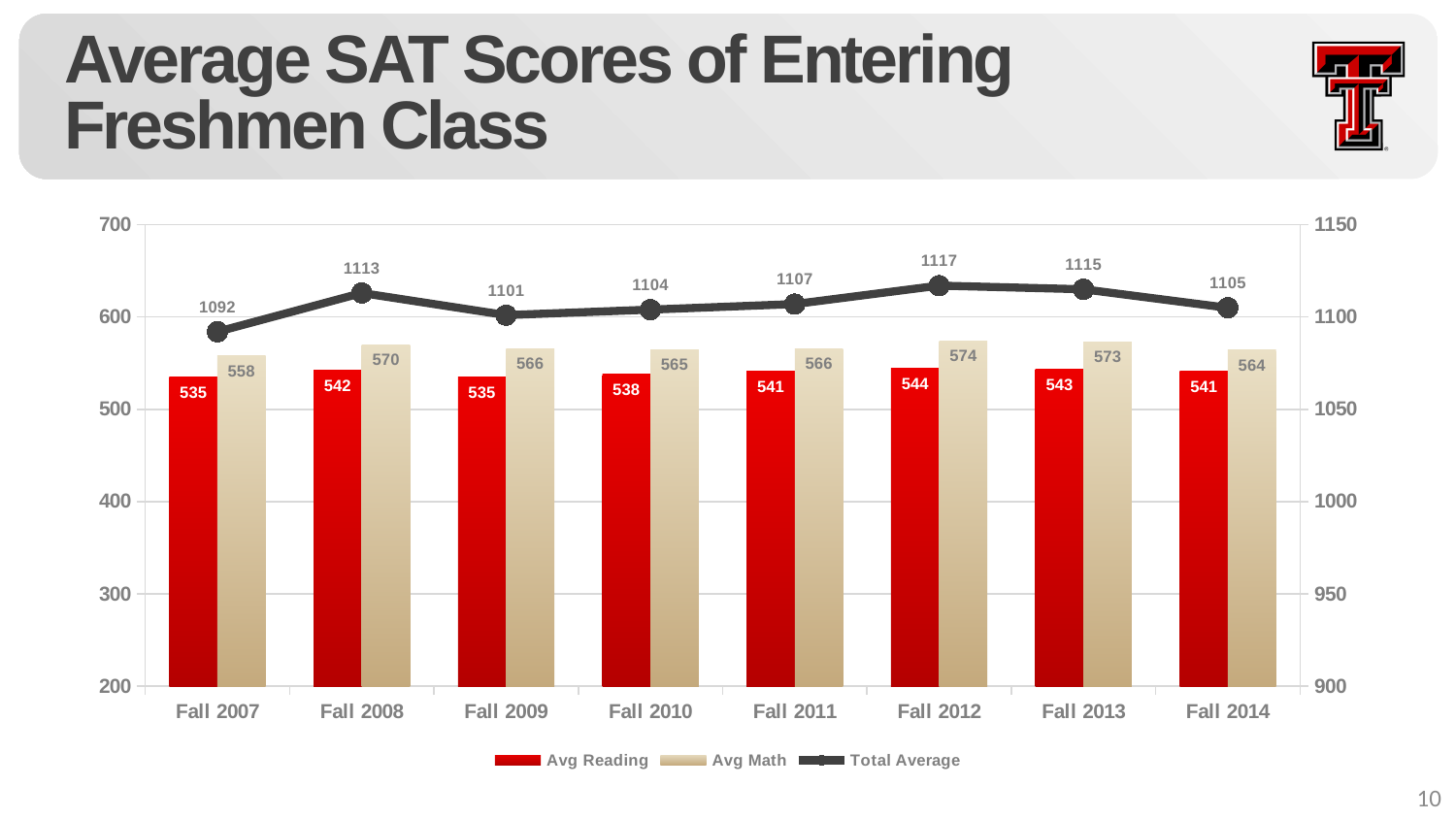
What is the title of the chart? Average SAT Scores of Entering Freshmen Class Which year has the highest Total Average? Fall 2012 What is the Avg Reading score for Fall 2012? 544 What kind of chart is this? Combined bar and line chart Which is larger, the Total Average for Fall 2013 or for Fall 2014? Fall 2013 What is the difference between the Avg Math and Avg Reading scores for Fall 2014? 23 What is the Total Average for Fall 2007? 1092 Which year has the lowest Avg Math score? Fall 2007 What is the Avg Math score for Fall 2008? 570 How many series does the legend list? 3 Does the Total Average rise or fall from Fall 2012 to Fall 2014? Fall How many years are shown on the x axis? 8